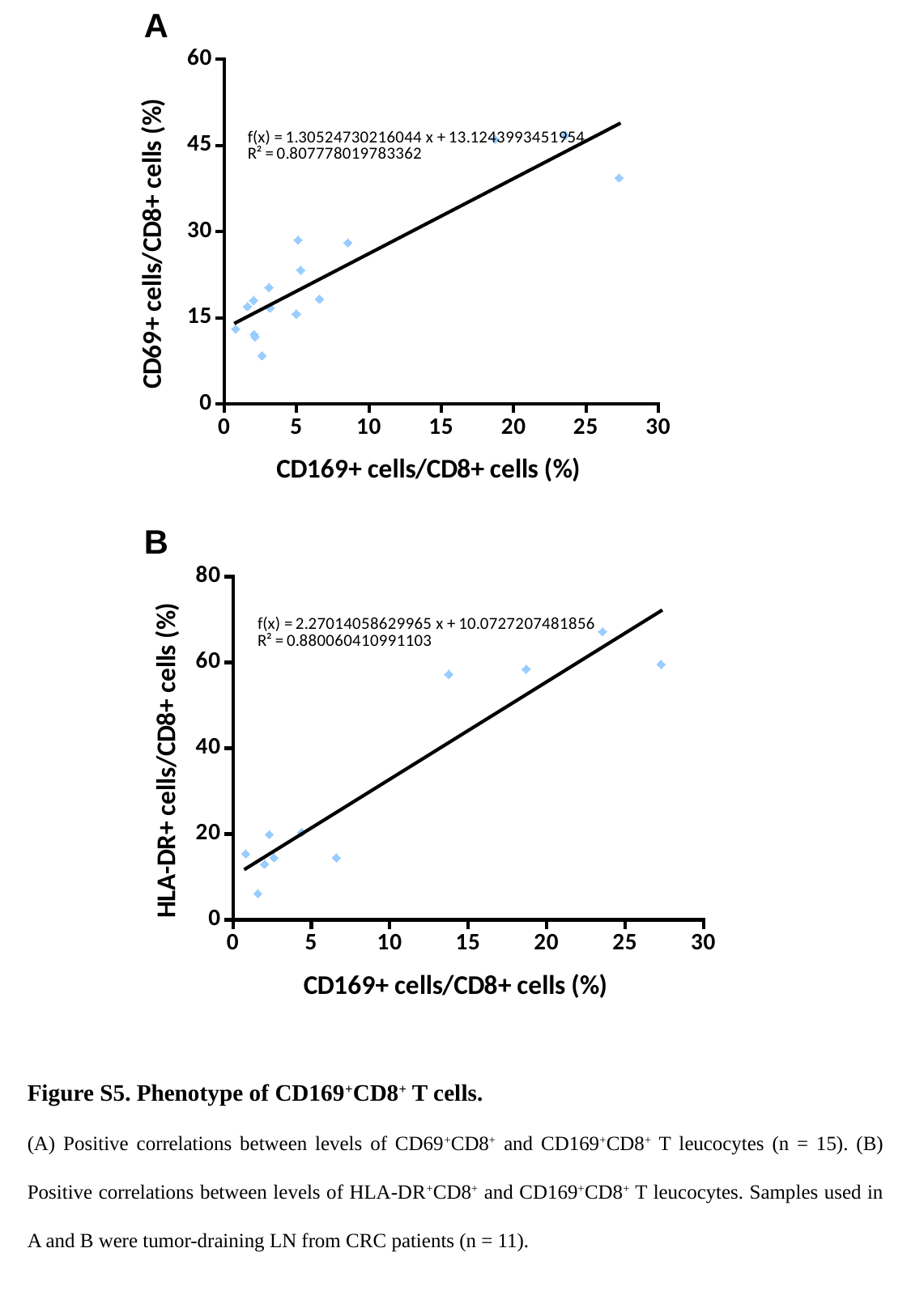
What is the trendline equation printed on chart B? f(x) = 2.27014058629965 x + 10.0727207481856 In chart A, do the values generally rise or fall as CD169+ cells/CD8+ cells (%) increases? rise In chart B, do the values generally rise or fall along the x axis? rise In chart B, is the y value of the point at about x = 23.5 greater or less than 60? greater In chart A, is the y value of the point at about x = 27 greater or less than 30? greater What is the R² value printed on chart B? 0.880060410991103 In chart B, is the y value of the point at about x = 6.5 greater or less than 20? less What is the trendline equation printed on chart A? f(x) = 1.30524730216044 x + 13.1243993451954 What kind of chart is chart A? scatter chart What is the y-axis title of chart B? HLA-DR+ cells/CD8+ cells (%) What is the R² value printed on chart A? 0.807778019783362 What is the x-axis title of chart A? CD169+ cells/CD8+ cells (%)